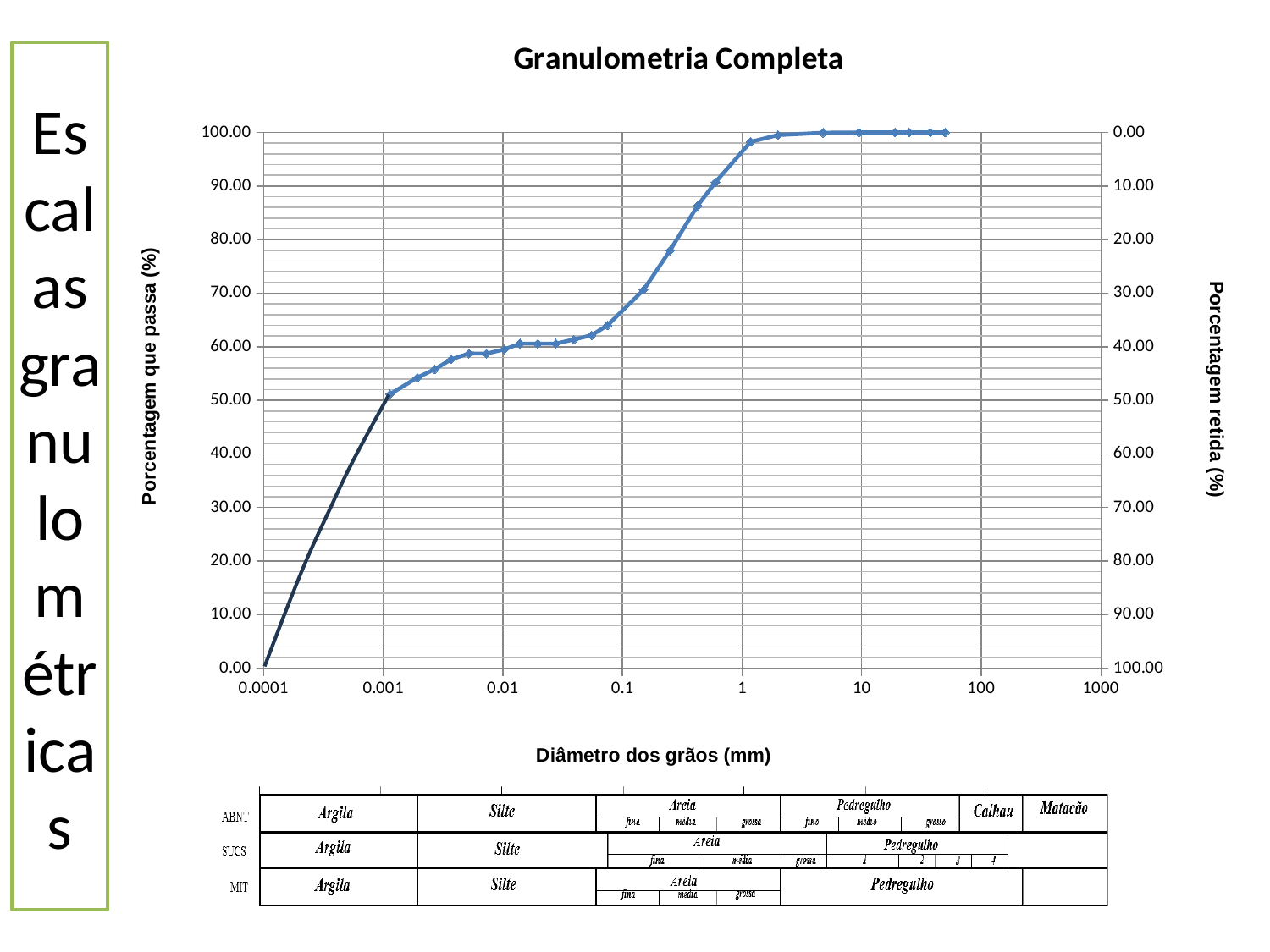
What kind of chart is shown on the slide? line chart Does the percentage passing rise or fall as the grain diameter increases along the x axis? rises What is the title of the chart? Granulometria Completa Is the percentage passing at a grain diameter of 0.0001 mm greater or less than 10.00? less Is the percentage passing at a grain diameter of 1 mm greater or less than 90.00? greater What is the percentage passing at the smallest grain diameter shown, 0.0001 mm? 0.00 Is the percentage passing at a grain diameter of 0.001 mm greater or less than 40.00? greater Which has a higher percentage passing: a grain diameter of 0.01 mm or 1 mm? 1 mm What is the title of the x axis of the chart? Diâmetro dos grãos (mm)